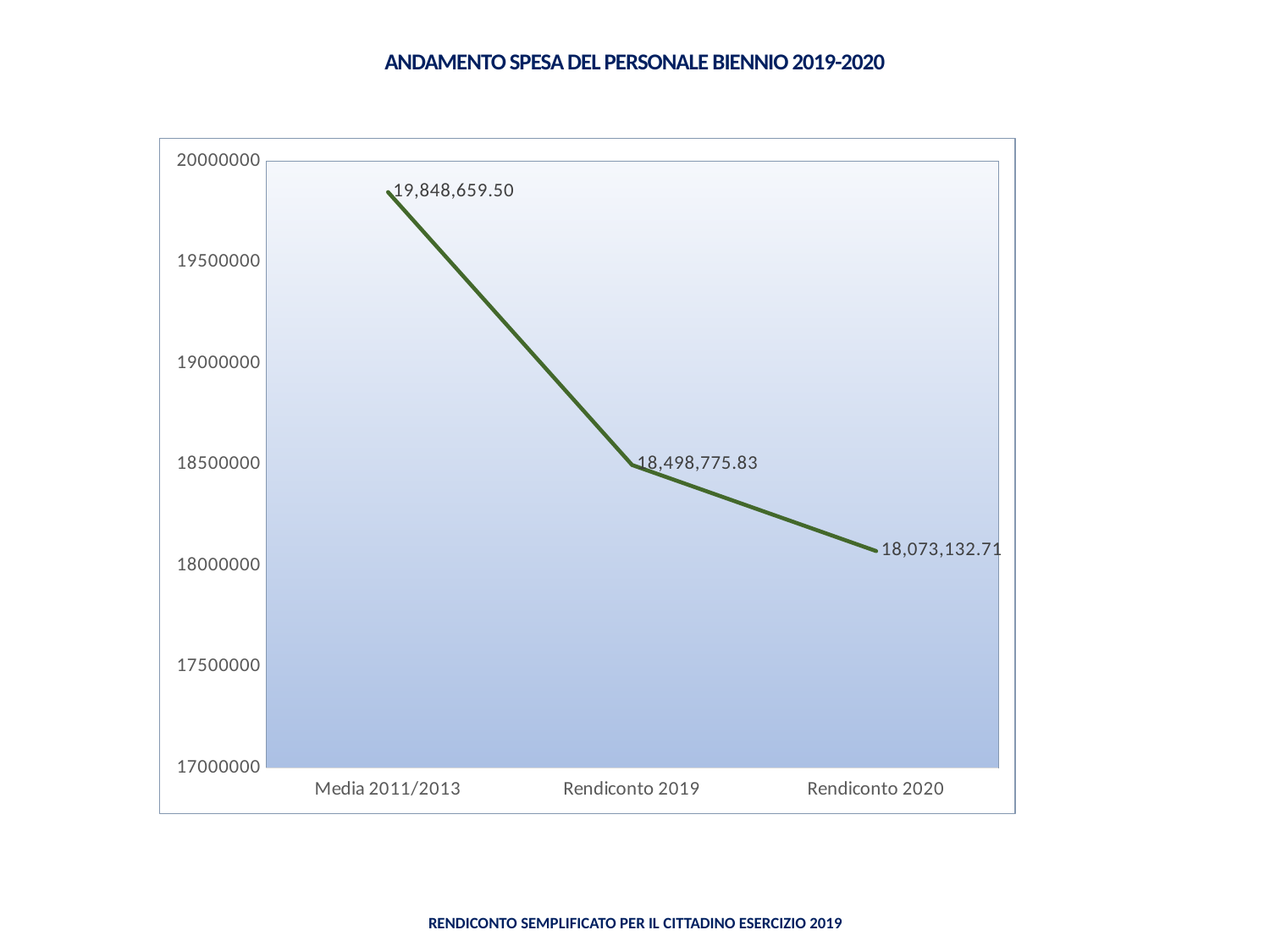
Which is larger, the value for Rendiconto 2019 or Rendiconto 2020? Rendiconto 2019 What is the value for Rendiconto 2019? 18,498,775.83 What is the value for Media 2011/2013? 19,848,659.50 What kind of chart is shown on the slide? line chart What is the difference between the values for Rendiconto 2019 and Rendiconto 2020? 425,643.12 Do the values rise or fall from Media 2011/2013 to Rendiconto 2020? fall Which category has the lowest value? Rendiconto 2020 What is the difference between the values for Media 2011/2013 and Rendiconto 2019? 1,349,883.67 Which category has the highest value? Media 2011/2013 What is the value for Rendiconto 2020? 18,073,132.71 Is the value for Rendiconto 2020 greater or less than 18500000? less How many categories are plotted on the x axis? 3